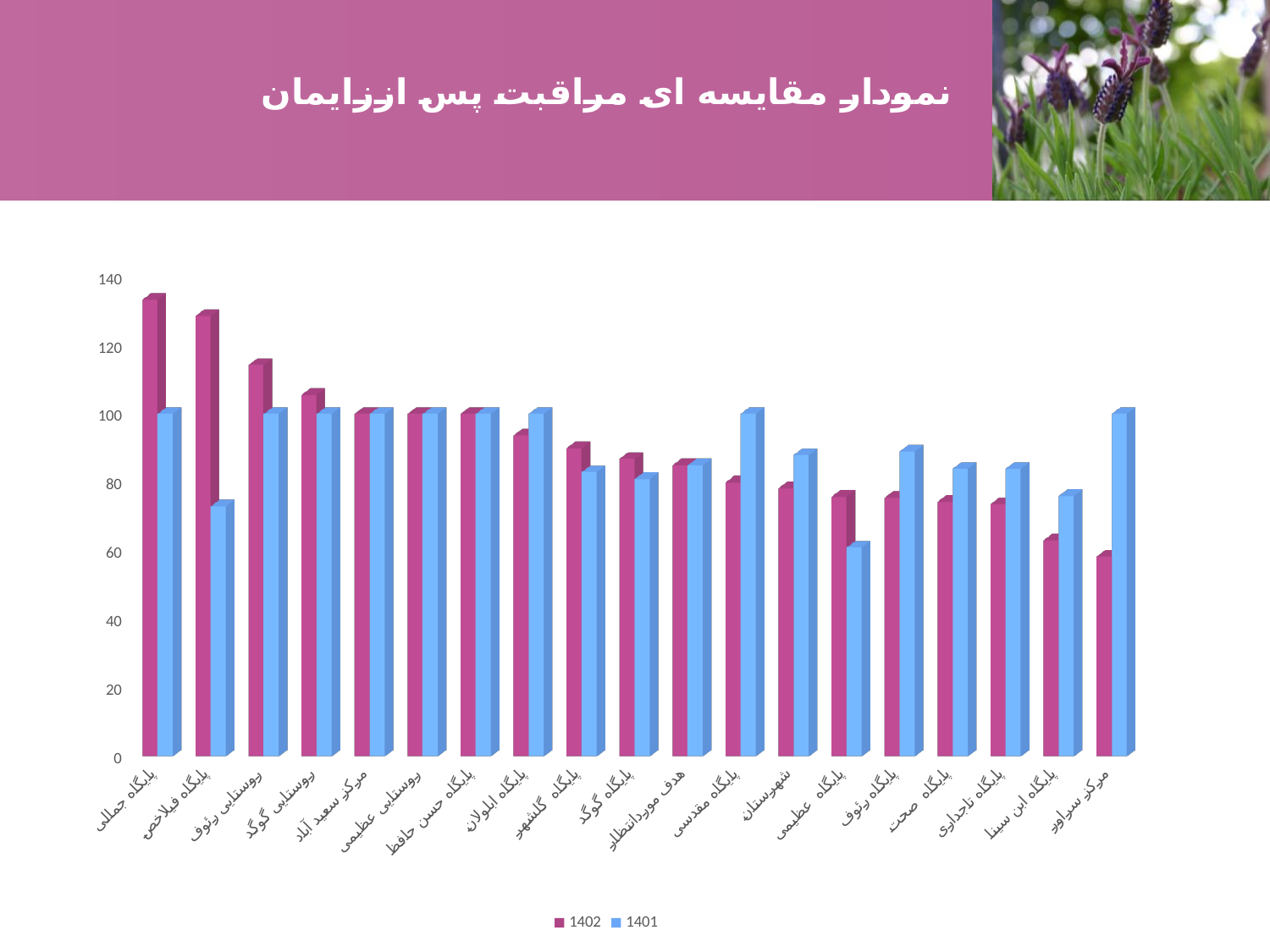
For پایگاه فیلاخص, which series has the larger value, 1402 or 1401? 1402 Which category has the lowest value for the 1402 series? مرکز سراور Is the 1401 value for پایگاه فیلاخص greater or less than 80? less What are the two series named in the legend? 1402 and 1401 Is the 1402 value for مرکز سرآور greater or less than 80? less How many categories are shown along the x axis? 19 What kind of chart is shown on the slide? bar chart Which category has the highest value for the 1402 series? پایگاه جمالی For مرکز سرآور, which series has the larger value, 1402 or 1401? 1401 Which category has the lowest value for the 1401 series? پایگاه عظیمی How many series does the legend list? 2 Is the 1402 value for پایگاه جمالی greater or less than 120? greater